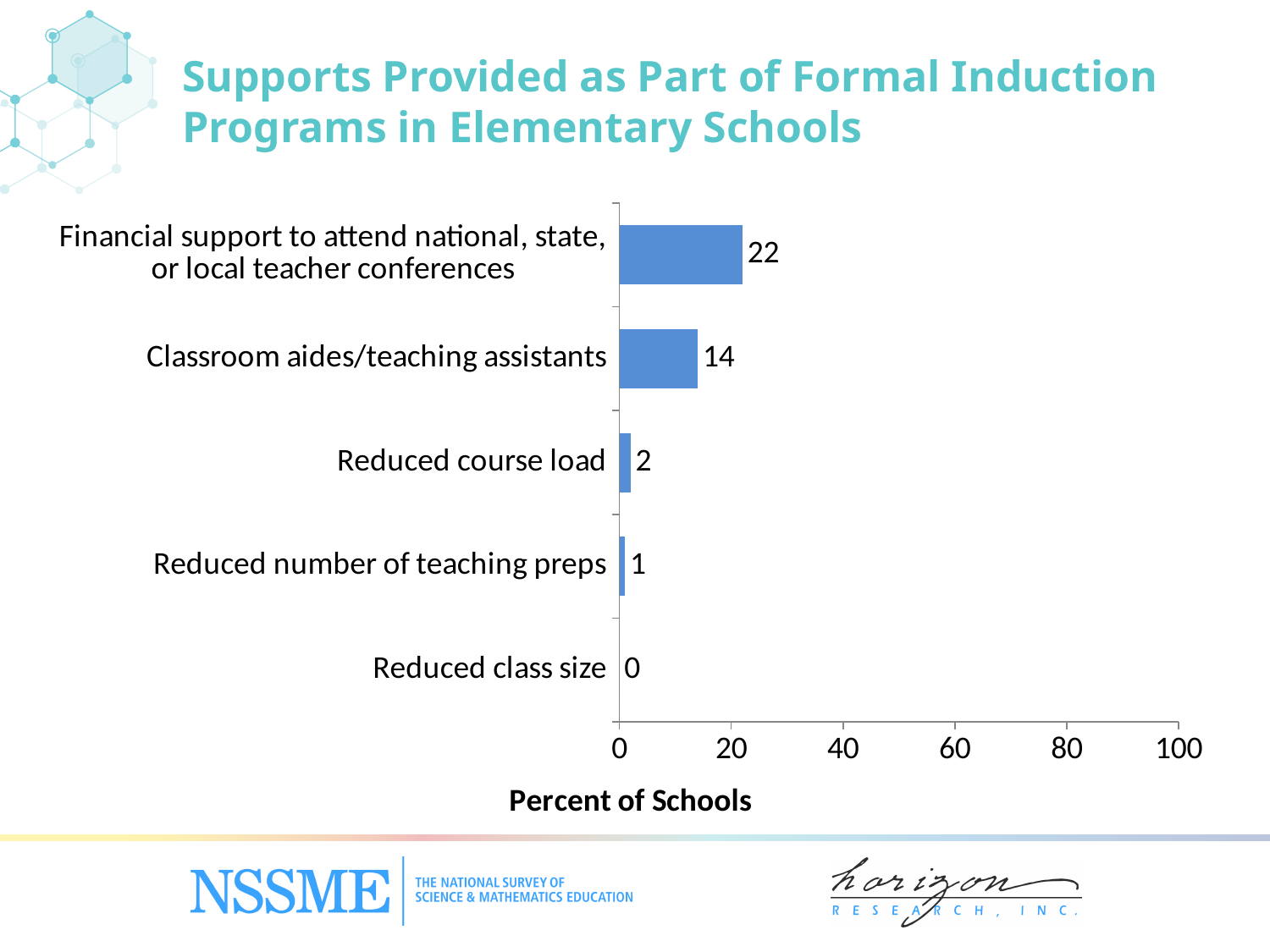
Which support has the lowest percent of schools? Reduced class size What is the label of the horizontal axis? Percent of Schools What is the value for reduced number of teaching preps? 1 What is the value for reduced course load? 2 Which support has the highest percent of schools? Financial support to attend national, state, or local teacher conferences What percent of schools provide classroom aides/teaching assistants? 14 What is the value for reduced class size? 0 What kind of chart is shown on the slide? Bar chart How many categories are shown in the chart? 5 Which is larger: the value for reduced course load or the value for reduced number of teaching preps? Reduced course load What is the difference between the values for financial support to attend teacher conferences and classroom aides/teaching assistants? 8 What percent of schools provide financial support to attend national, state, or local teacher conferences? 22